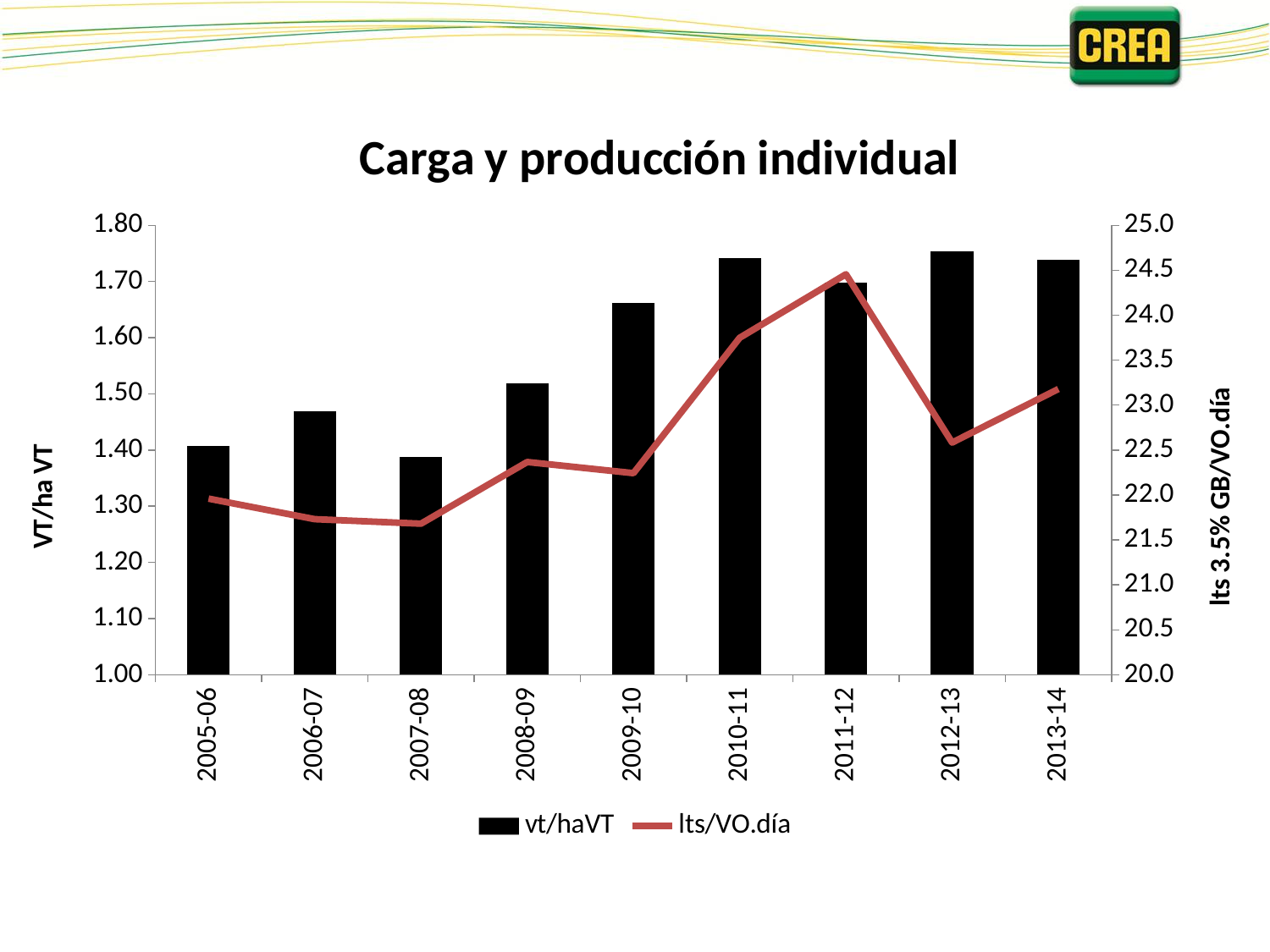
What kind of chart is shown on the slide? A combination bar and line chart Which period has the larger vt/haVT bar, 2008-09 or 2009-10? 2009-10 In which period does the lts/VO.día line reach its highest value? 2011-12 Is the vt/haVT value for 2009-10 greater or less than 1.60? greater Is the lts/VO.día value for 2006-07 greater or less than 22.0? less Is the vt/haVT value for 2005-06 greater or less than 1.50? less Do the vt/haVT bars rise or fall from 2007-08 to 2010-11? rise How many series does the legend list? 2 What is the title of the chart? Carga y producción individual How many periods are shown on the x axis? 9 In which period is the vt/haVT bar the lowest? 2007-08